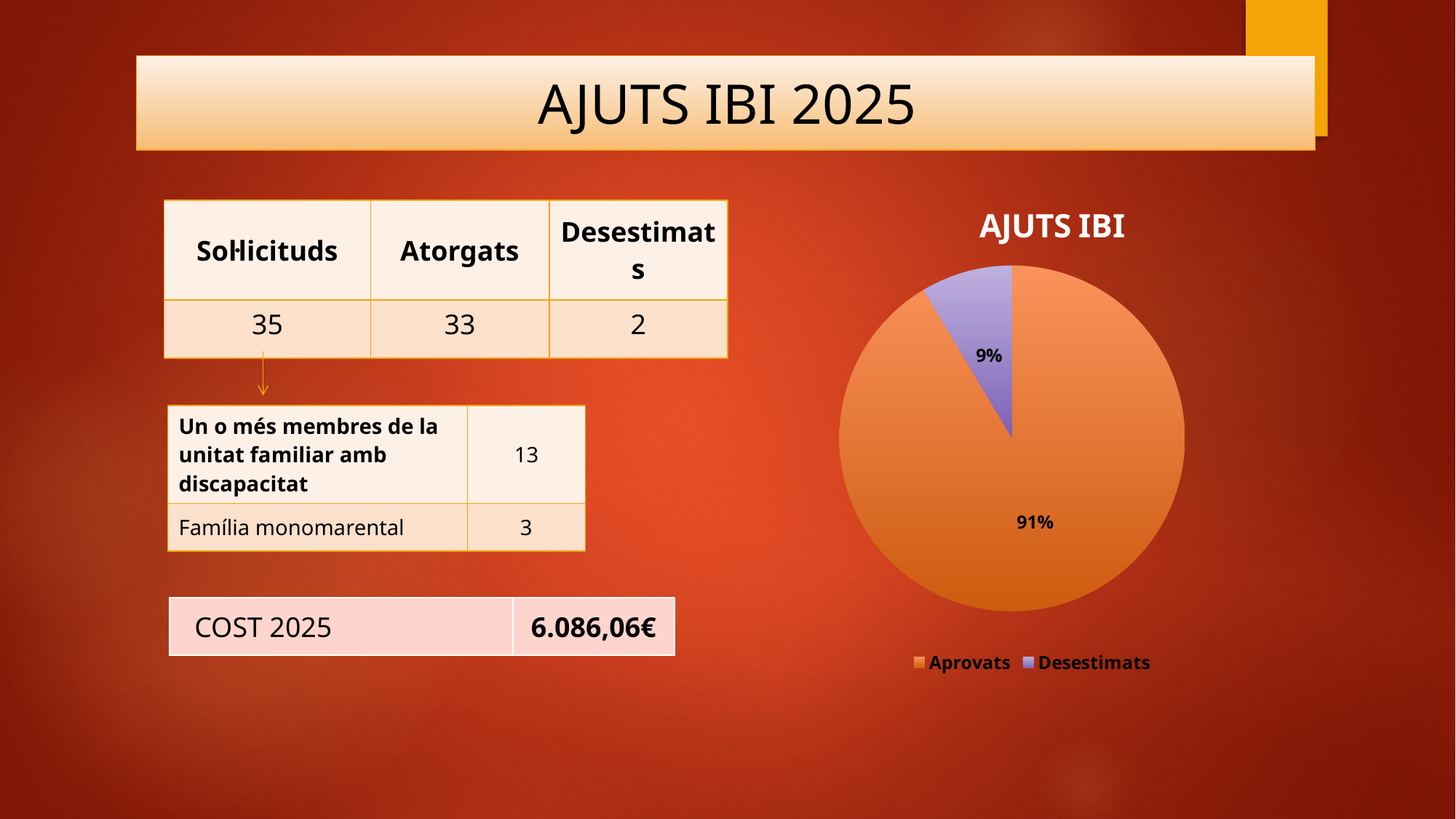
What share of the pie does Desestimats represent? 9% What kind of chart is shown on the slide? pie chart How many slices does the pie chart have? 2 What is the difference in percentage points between the Aprovats and Desestimats slices? 82 What share of the pie does Aprovats represent? 91% Which slice of the pie is the smallest? Desestimats Which slice of the pie is the largest? Aprovats What is the title of the chart? AJUTS IBI How many entries does the legend list? 2 What colour is the Desestimats slice? purple Which is larger, the Aprovats slice or the Desestimats slice? Aprovats